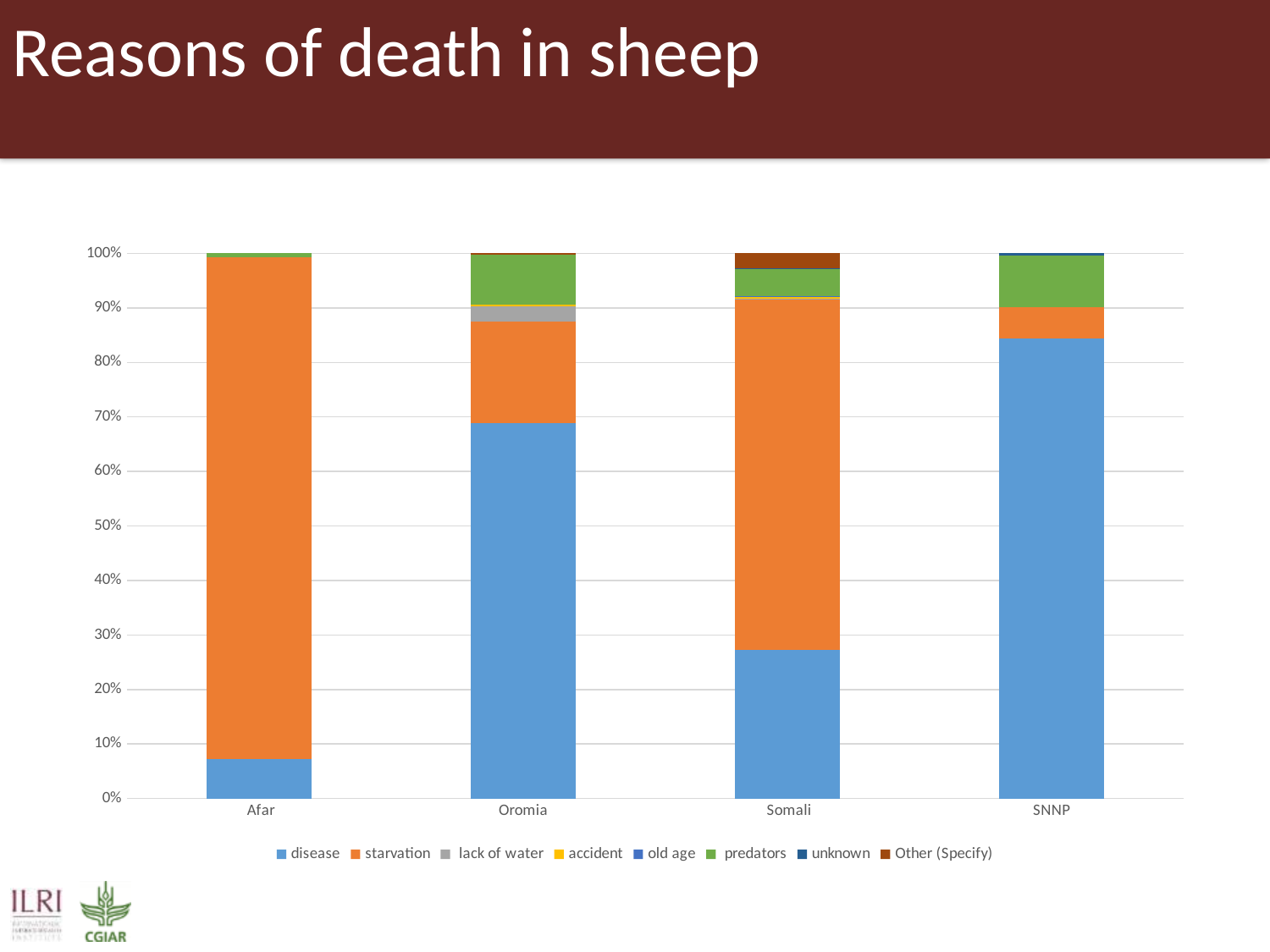
Is the share of deaths due to disease in SNNP greater or less than 80%? greater Is the share of deaths due to disease in Somali greater or less than 20%? greater Which colour represents starvation in the legend? orange What kind of chart is shown on the slide? stacked bar chart Is the share of deaths due to disease in Afar greater or less than 10%? less Which region has the largest share of deaths due to disease? SNNP How many series does the legend list? 8 Which region has the smallest share of deaths due to disease? Afar Which region has the largest share of deaths due to starvation? Afar Which region has a larger share of deaths due to disease, Oromia or Somali? Oromia How many regions are shown on the x axis of the chart? 4 What is the title of the slide? Reasons of death in sheep